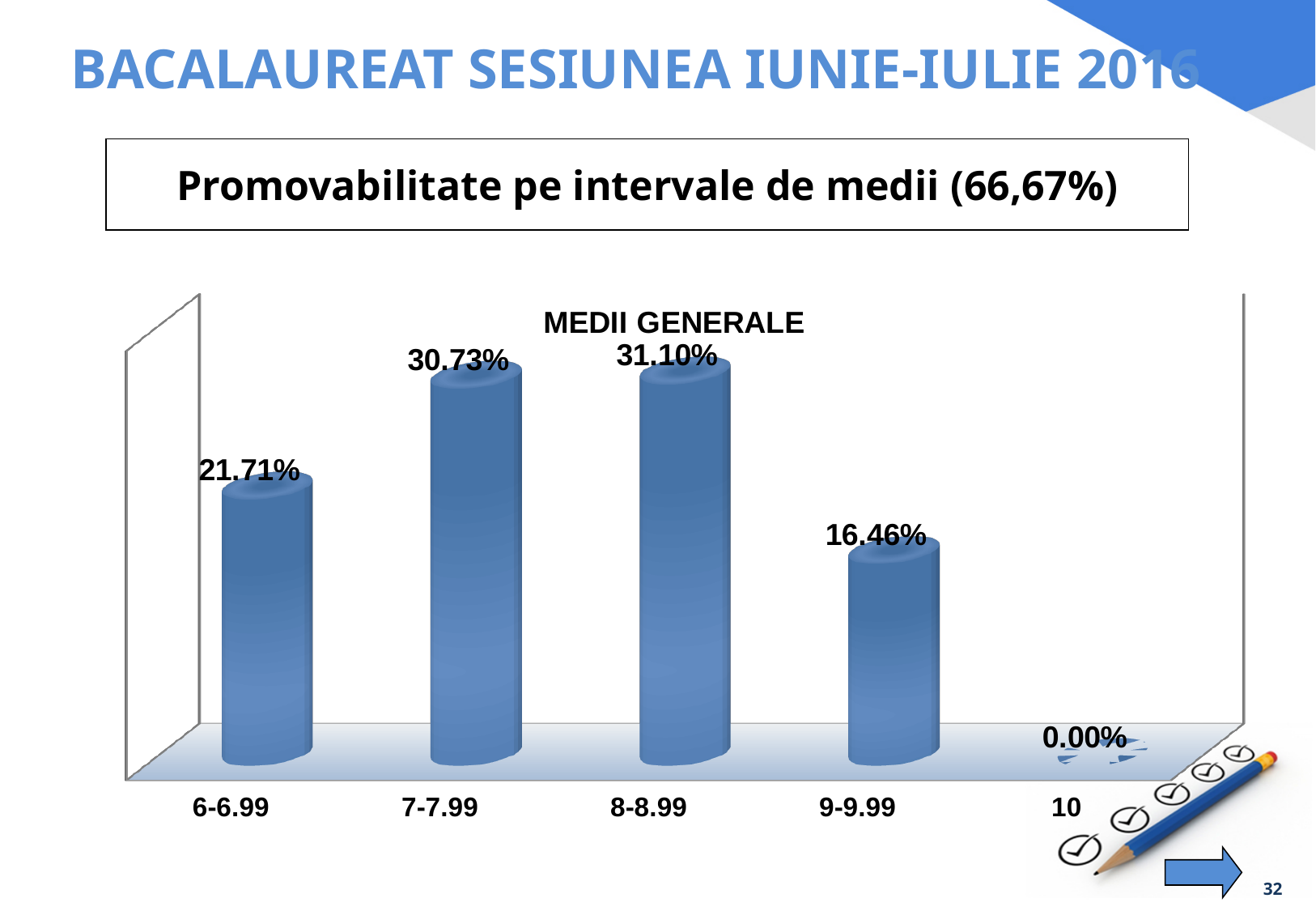
What is the value for the 9-9.99 interval? 16.46% What is the value for the 10 category? 0.00% What kind of chart is shown on the slide? bar chart What is the title printed above the bars of the chart? MEDII GENERALE Which interval has the highest value? 8-8.99 What is the value for the 6-6.99 interval? 21.71% What is the difference between the values for 7-7.99 and 6-6.99? 9.02% How many categories are shown on the x axis? 5 What is the value for the 7-7.99 interval? 30.73% Which is larger, the value for 6-6.99 or the value for 9-9.99? 6-6.99 Which category has the lowest value? 10 What is the difference between the values for 8-8.99 and 7-7.99? 0.37%